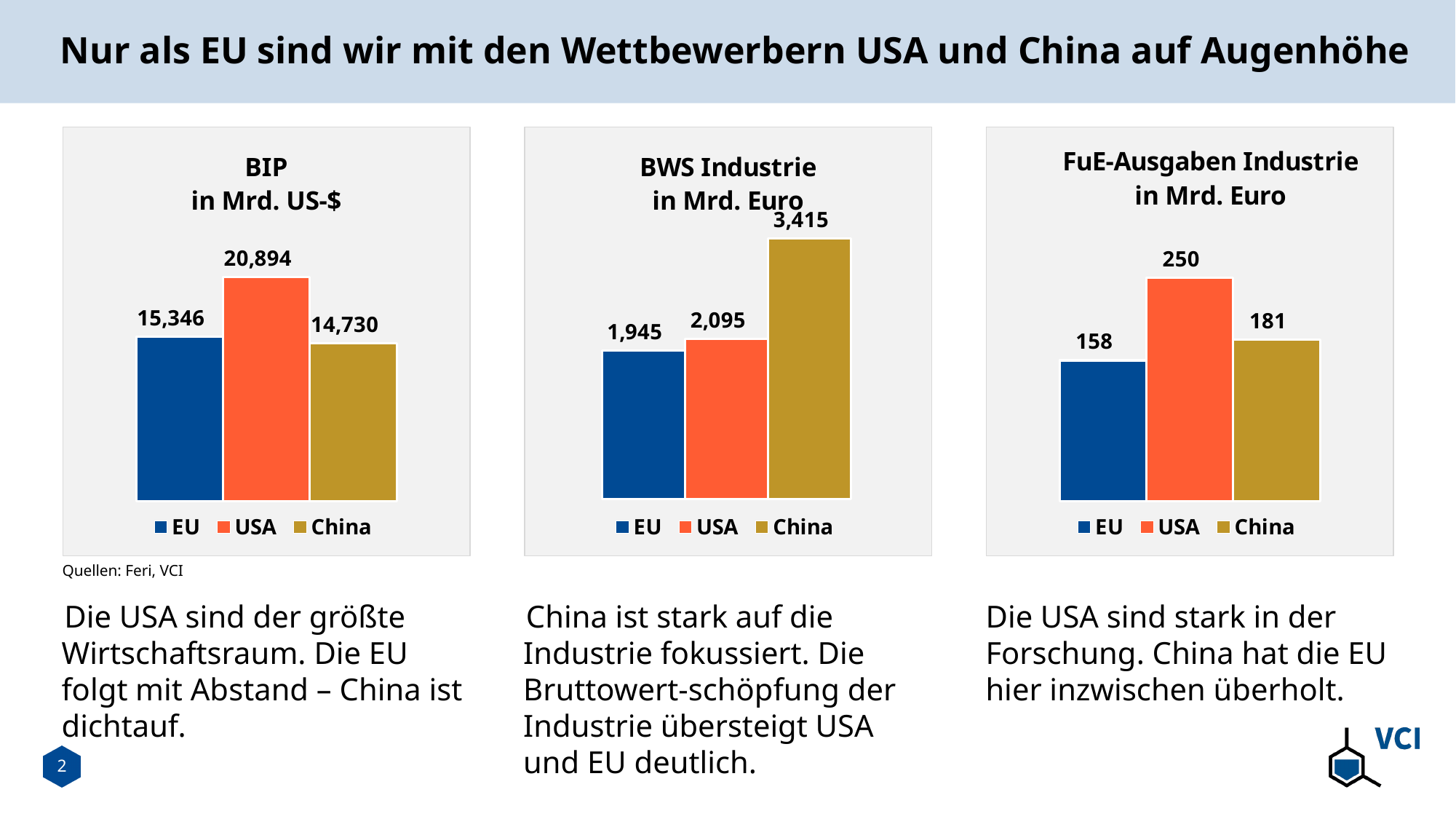
How many series does the legend of the 'BIP in Mrd. US-$' chart list? 3 In the 'BIP in Mrd. US-$' chart, what is the difference between the USA and the EU? 5,548 In the 'BIP in Mrd. US-$' chart, what is the value for the USA? 20,894 In the 'FuE-Ausgaben Industrie in Mrd. Euro' chart, what is the difference between the USA and China? 69 In the 'BWS Industrie in Mrd. Euro' chart, what is the value for China? 3,415 In the 'FuE-Ausgaben Industrie in Mrd. Euro' chart, what colour is the bar for the USA? Orange What kind of chart is the 'BWS Industrie in Mrd. Euro' chart? Bar chart In the 'FuE-Ausgaben Industrie in Mrd. Euro' chart, which is larger, the value for China or the value for the EU? China In the 'BIP in Mrd. US-$' chart, which region has the lowest value? China In the 'BWS Industrie in Mrd. Euro' chart, what is the difference between the USA and the EU? 150 In the 'BWS Industrie in Mrd. Euro' chart, which region has the highest value? China In the 'FuE-Ausgaben Industrie in Mrd. Euro' chart, what is the value for the EU? 158